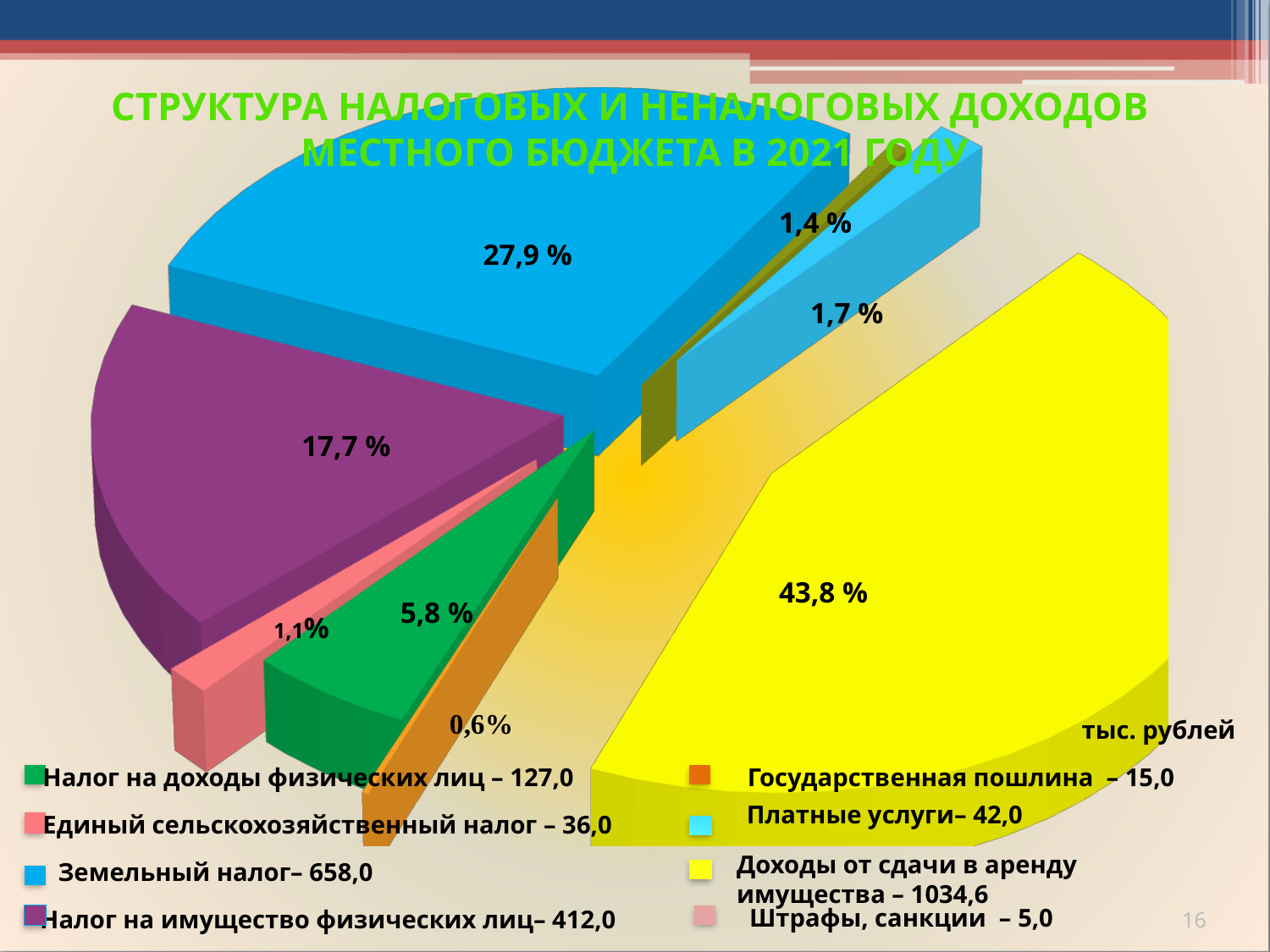
How many entries does the legend list? 8 According to the legend, what is the value for Доходы от сдачи в аренду имущества? 1034,6 What is the difference between the legend values for Доходы от сдачи в аренду имущества (1034,6) and Земельный налог (658,0)? 376,6 Which is larger according to the legend: Налог на доходы физических лиц or Налог на имущество физических лиц? Налог на имущество физических лиц Which category has the largest share of the pie? Доходы от сдачи в аренду имущества What share of the pie does the blue slice (Земельный налог) represent? 27,9 % According to the legend, what is the value for Земельный налог? 658,0 What share of the pie does the green slice (Налог на доходы физических лиц) represent? 5,8 % What share of the pie does the purple slice (Налог на имущество физических лиц) represent? 17,7 % What kind of chart is shown on the slide? pie chart What is the smallest percentage labelled on the pie? 0,6%